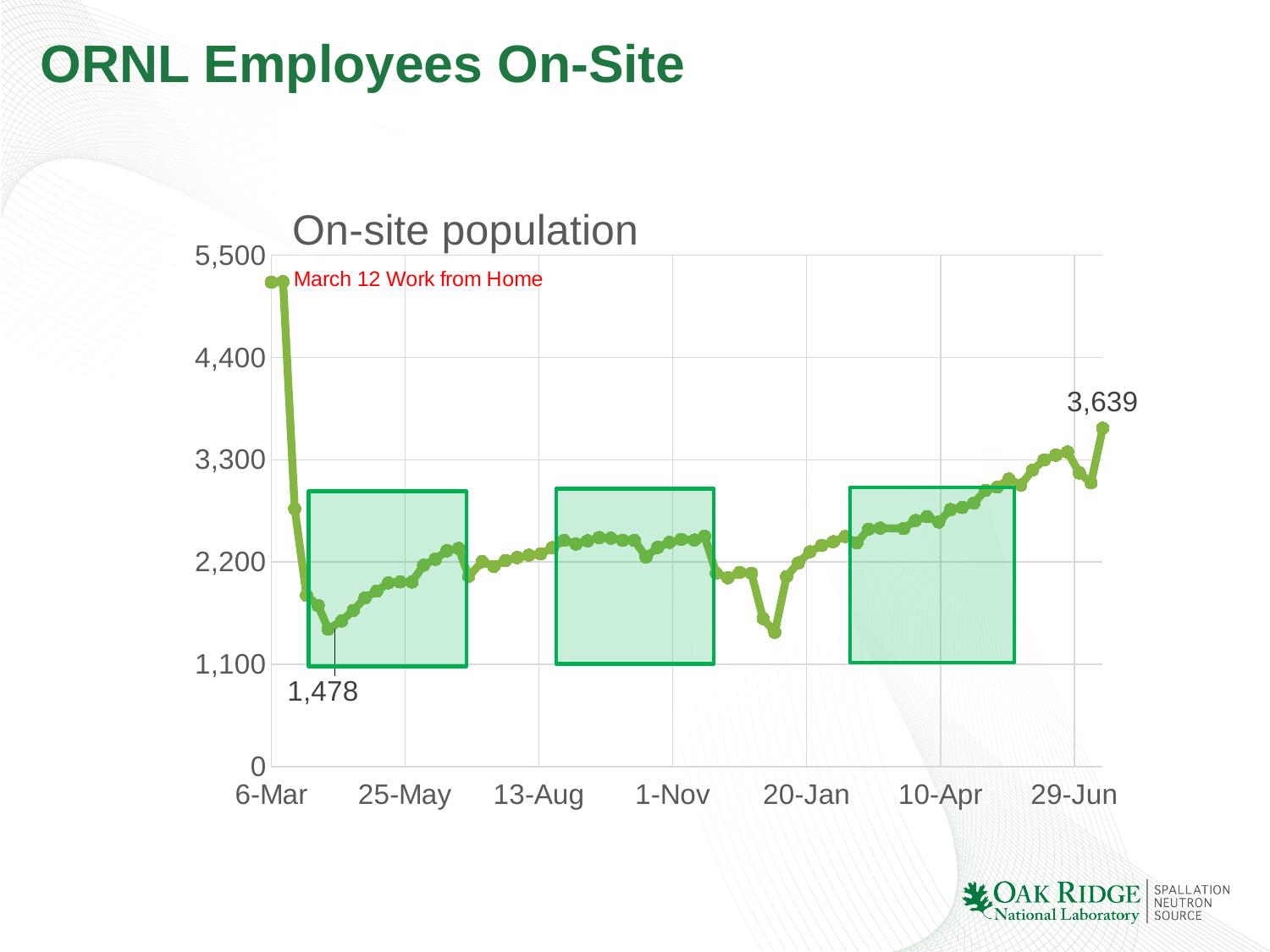
What is the labeled value at the end of the series, near 29-Jun? 3,639 Is the value at 10-Apr greater or less than 2,200? greater What does the red annotation near the top of the chart say? March 12 Work from Home What is the lowest labeled value on the chart? 1,478 Is the value at the dip just before 20-Jan greater or less than 2,200? less What kind of chart is shown on the slide? line chart What is the title of the chart? On-site population What is the difference between the final labeled value (3,639) and the lowest labeled value (1,478)? 2,161 How many date labels are shown on the x axis? 7 Is the value at 6-Mar greater or less than 4,400? greater Do the values rise or fall between 6-Mar and the labeled low point of 1,478? fall Which is larger, the value at 6-Mar or the value at 29-Jun? 6-Mar